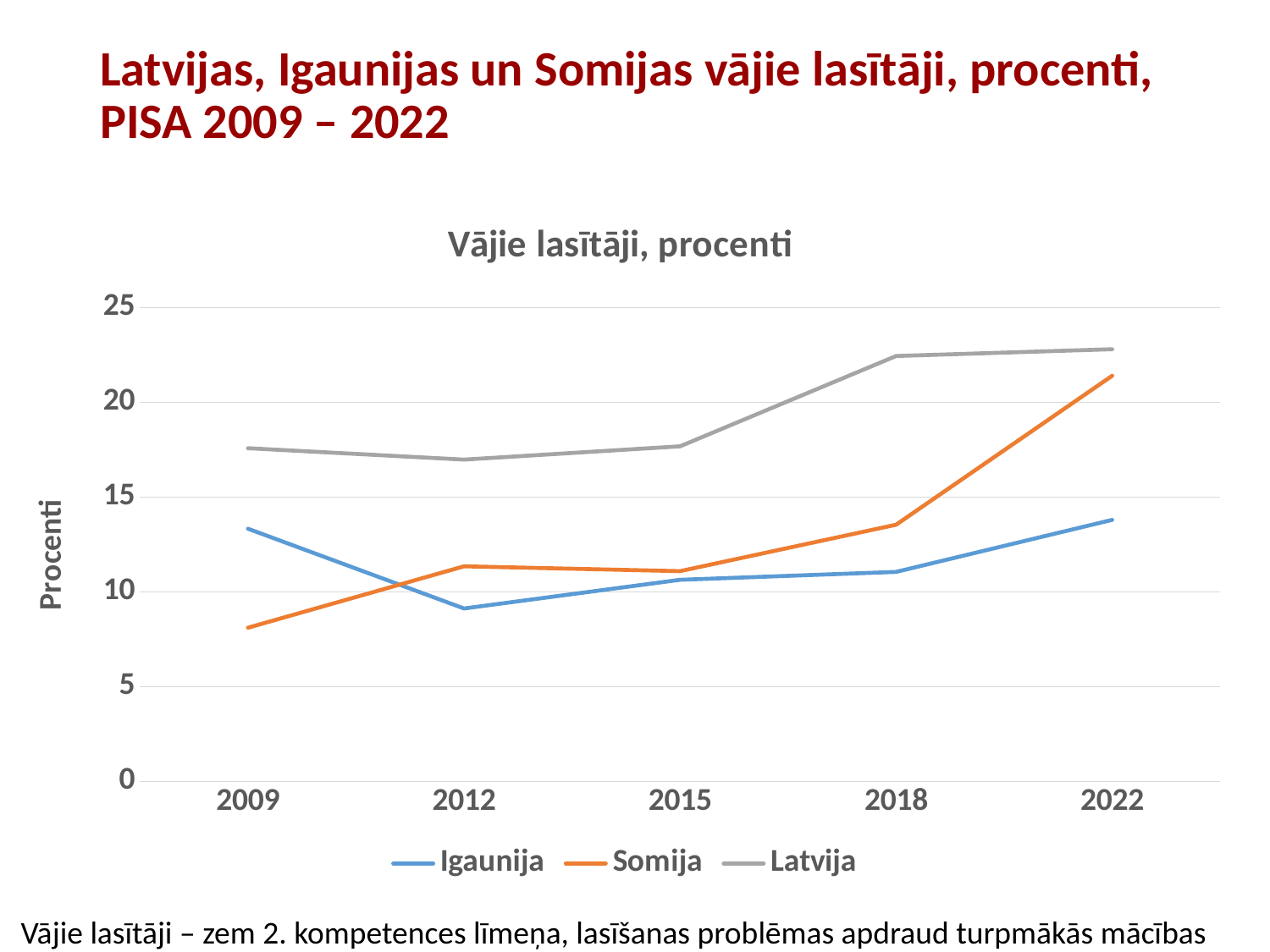
Is the value for Latvija in 2022 greater or less than 20? greater How many years are plotted along the x axis? 5 What is the label of the y axis? Procenti What kind of chart is shown on the slide? line chart Is the value for Igaunija in 2022 greater or less than 15? less What is the title of the chart? Vājie lasītāji, procenti How many series does the legend list? 3 In 2009, which is larger: the value for Igaunija or the value for Somija? Igaunija Is the value for Somija in 2009 greater or less than 10? less Does the value for Somija rise or fall between 2018 and 2022? rise Which series has the lowest value in 2009? Somija Which series has the highest value in 2022? Latvija